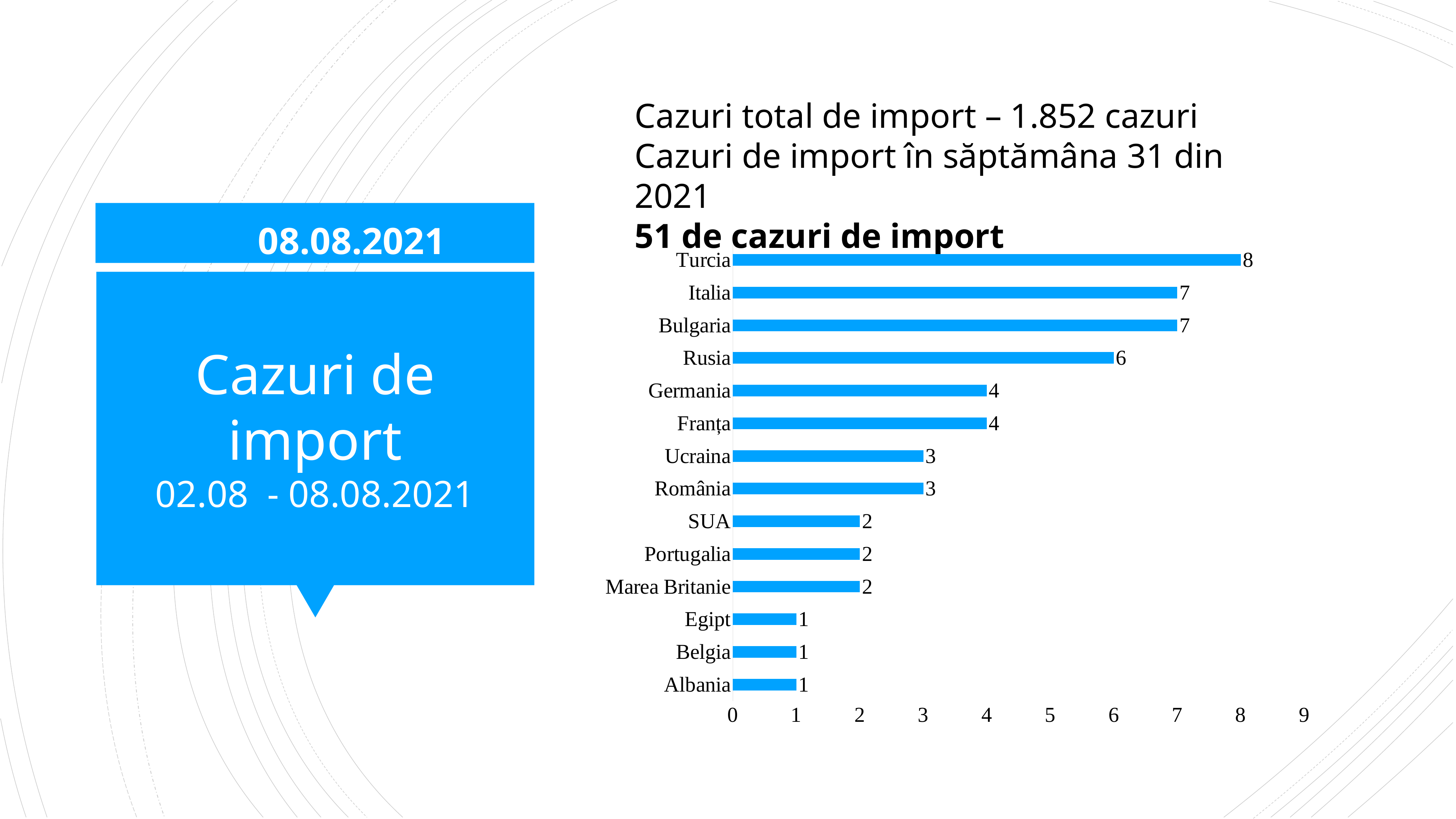
Which is larger, the value for SUA or the value for Bulgaria? Bulgaria What is the difference between the values for Turcia and Germania? 4 What kind of chart is shown on the slide? bar chart Which is larger, the value for Rusia or the value for Franța? Rusia What is the highest value shown on the horizontal axis? 9 What is the value for Turcia? 8 What is the value for Rusia? 6 Which country has the highest value? Turcia What is the value for Ucraina? 3 What is the value for Marea Britanie? 2 What is the difference between the values for Italia and România? 4 How many countries are shown in the chart? 14